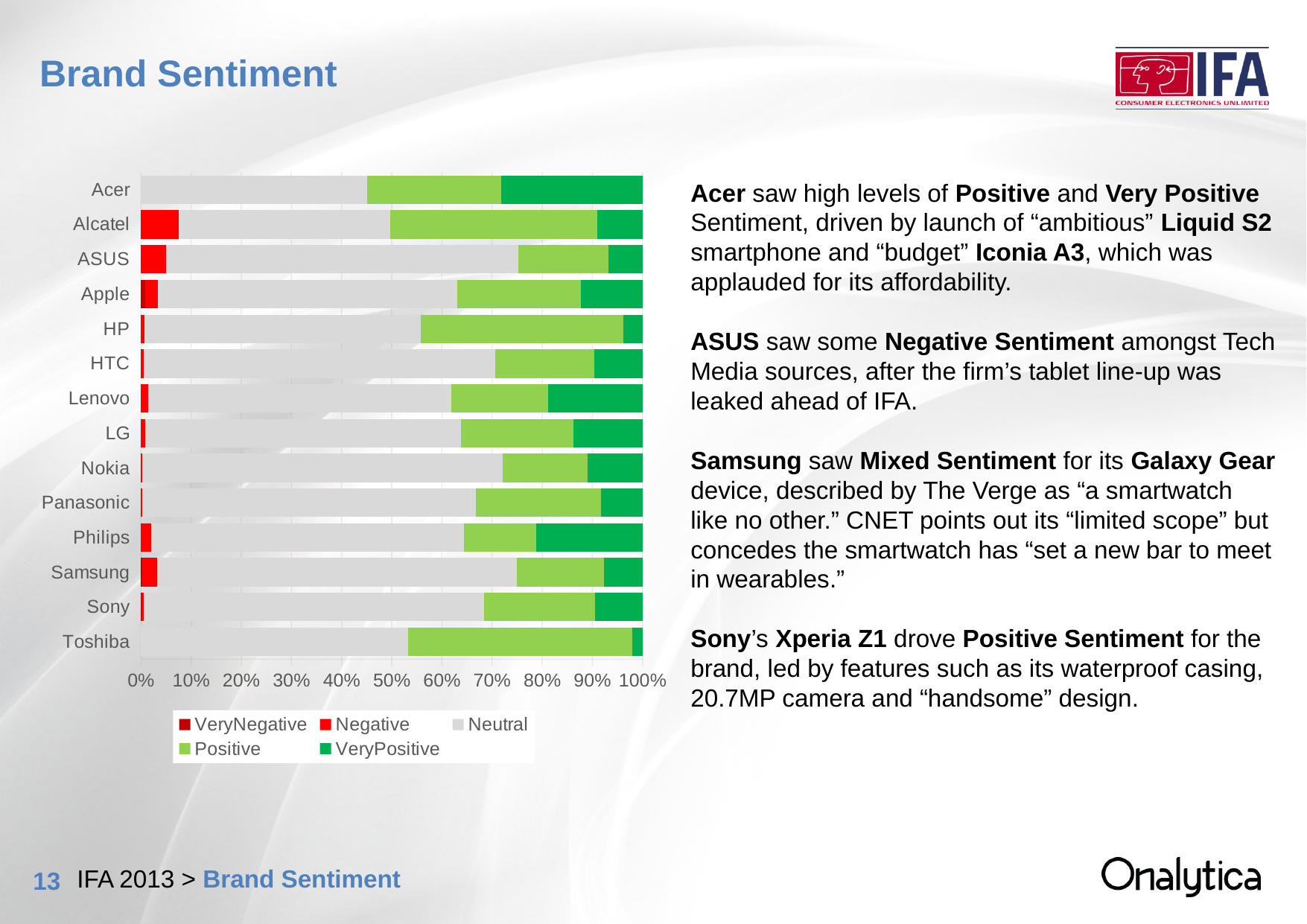
Which brand has the largest Negative share? Alcatel Is the Neutral share for Acer greater or less than 50%? less What kind of chart is shown on the slide? Stacked bar chart How many brands are shown on the chart? 14 Is the Neutral share for Toshiba greater or less than 50%? greater Which brand has the larger VeryPositive share, Acer or Toshiba? Acer Is the Negative share for Alcatel greater or less than 10%? less Which brand has the larger Negative share, Alcatel or Sony? Alcatel What colour represents the Neutral series in the legend? Grey Which brand has the smallest Neutral share? Alcatel How many series does the chart legend list? 5 Which brand has the largest VeryPositive share? Acer